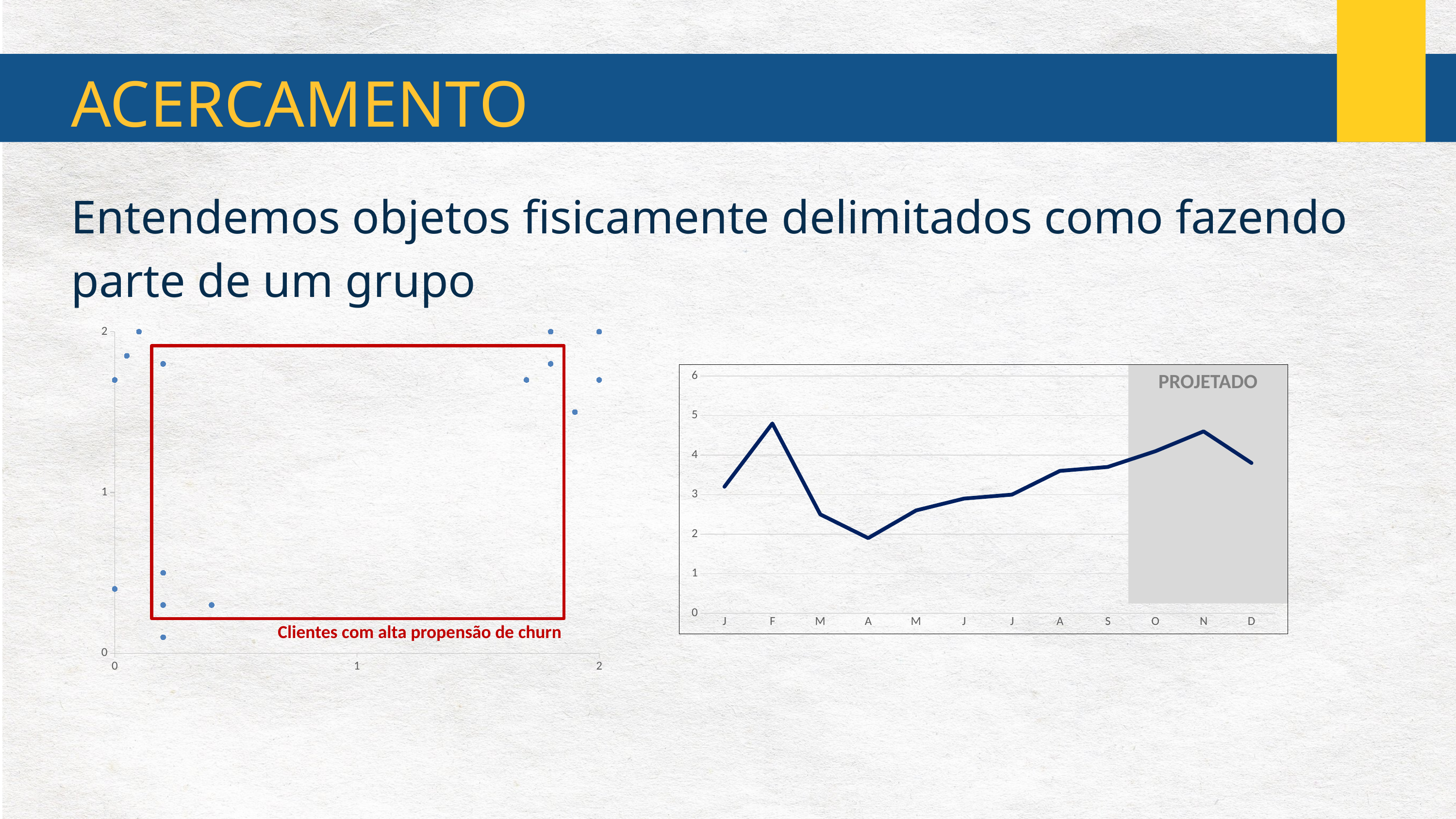
In the line chart on the right, which x-axis label has the lowest value? A (the fourth point) In the line chart on the right, is the value at N greater or less than 4? greater What kind of chart is the chart on the right of the slide? line chart In the line chart on the right, is the value at F greater or less than 4? greater What kind of chart is the chart on the left of the slide? scatter chart In the line chart on the right, does the line rise or fall from the fourth point (A) to N? rises In the line chart on the right, which x-axis label has the highest value? F In the line chart on the right, which is larger, the value at F or the value at the third point (M)? F In the line chart on the right, is the value at the third point (M) greater or less than 3? less What label appears in the shaded grey area of the line chart on the right? PROJETADO In the line chart on the right, how many points are plotted along the x axis? 12